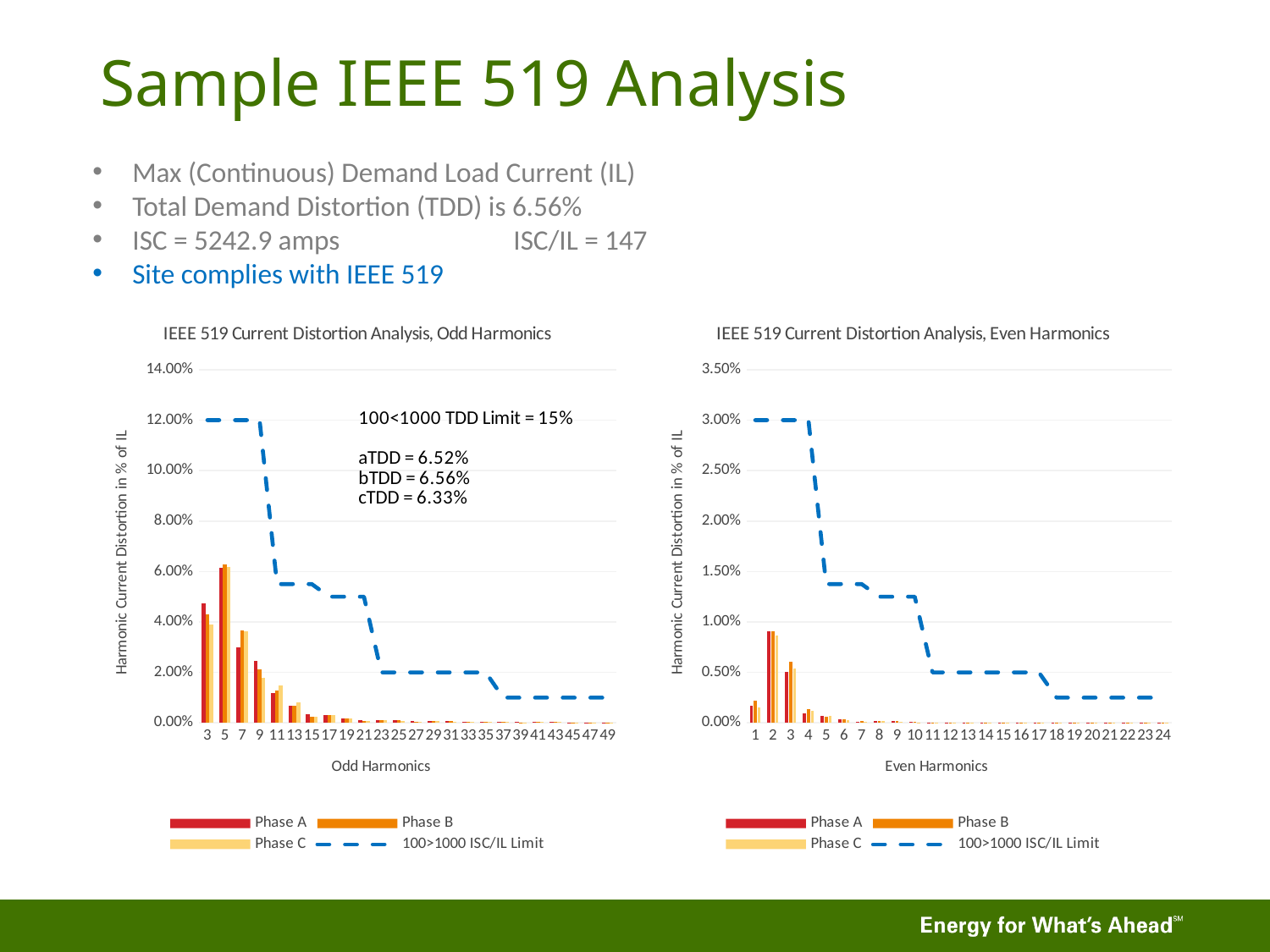
On the Even Harmonics chart, is the Phase A value at harmonic 1 greater or less than 0.50%? less On the Even Harmonics chart, which even harmonic has the highest phase current distortion bars? 2 On the Odd Harmonics chart, what is the value of bTDD shown in the annotation? 6.56% How many series does the legend of the Even Harmonics chart list? 4 On the Odd Harmonics chart, what TDD limit is stated in the annotation for 100<1000? 15% On the Odd Harmonics chart, is the Phase A value at harmonic 3 greater or less than 4.00%? greater On the Even Harmonics chart, is the Phase A value at harmonic 2 greater or less than 0.50%? greater On the Odd Harmonics chart, what is the value of cTDD shown in the annotation? 6.33% On the Odd Harmonics chart, do the phase distortion values generally rise or fall as the harmonic number increases? fall On the Odd Harmonics chart, which odd harmonic has the highest phase current distortion bars? 5 On the Odd Harmonics chart, is the Phase A value larger at harmonic 3 or at harmonic 5? harmonic 5 How many even harmonics are shown on the x axis of the Even Harmonics chart? 24